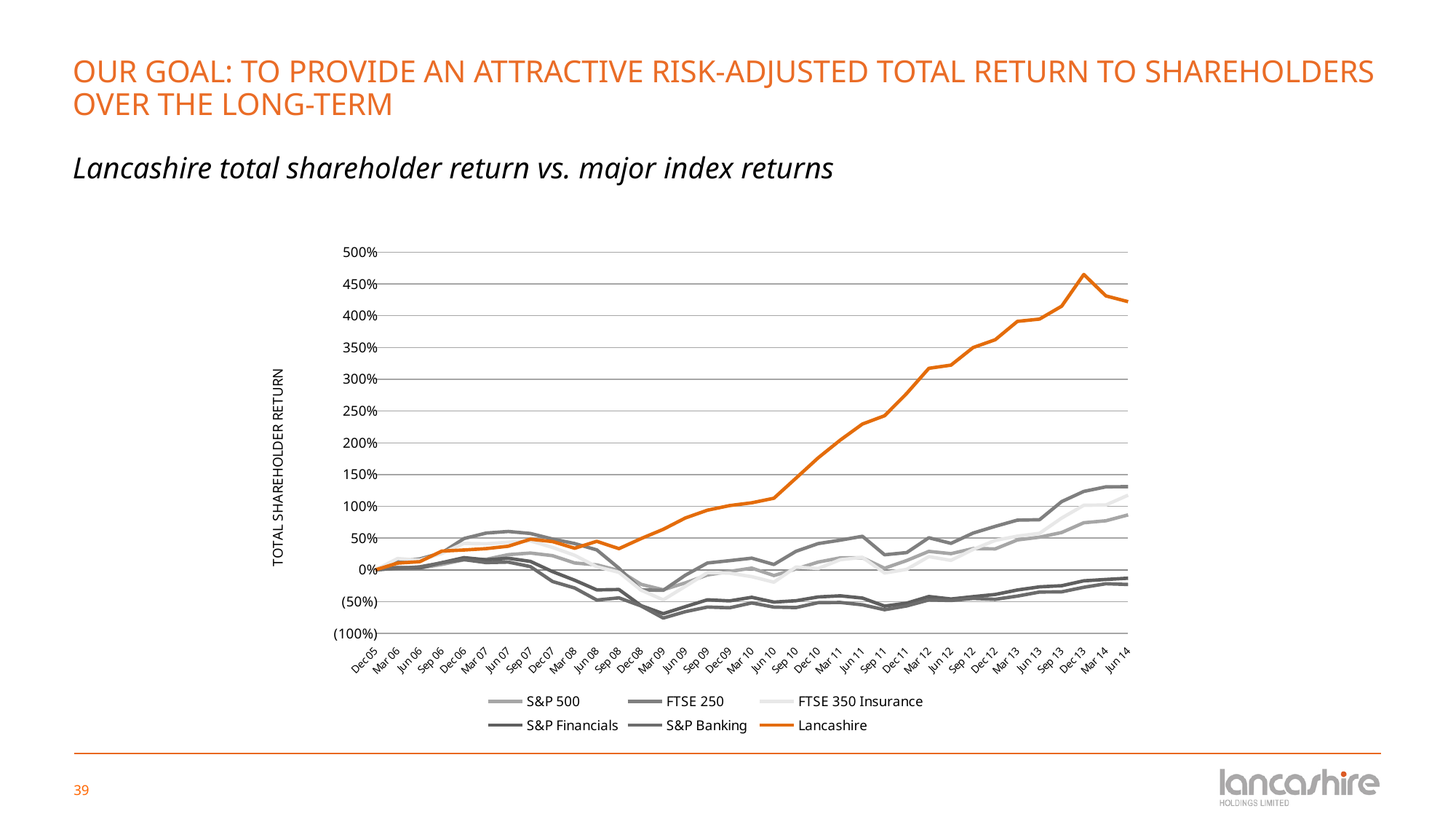
How many dates are shown along the x axis? 35 Does the Lancashire series generally rise or fall from Dec 05 to Dec 13? rise Is the value for Lancashire at Jun 14 greater or less than 400%? greater Is the value for Lancashire at Dec 13 greater or less than 450%? greater What is the label on the vertical axis of the chart? TOTAL SHAREHOLDER RETURN What kind of chart is shown on the slide? line chart How many series does the legend list? 6 Which is larger at Jun 14, Lancashire or S&P 500? Lancashire Which series is drawn in orange? Lancashire Which series has the highest value at Jun 14? Lancashire At which date does the Lancashire series reach its highest value? Dec 13 Is the value for Lancashire at Jun 10 greater or less than 100%? greater